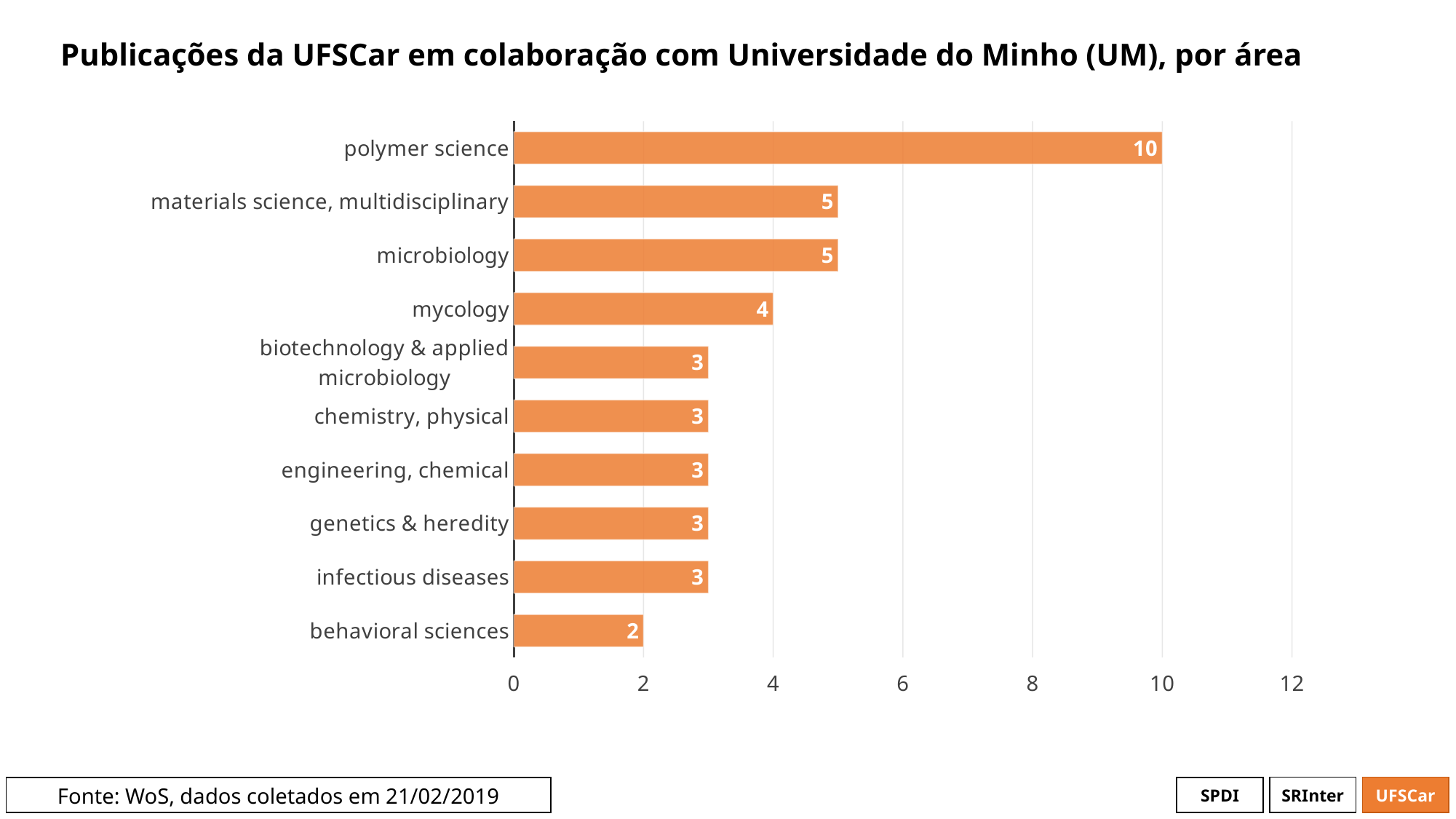
What is the value for microbiology? 5 What is the value for polymer science? 10 What is the value for behavioral sciences? 2 What kind of chart is shown on the slide? bar chart What is the title of the chart? Publicações da UFSCar em colaboração com Universidade do Minho (UM), por área Which is larger, the value for mycology or the value for infectious diseases? mycology What is the value for mycology? 4 Which area has the lowest value? behavioral sciences Is the value for polymer science greater or less than 8? greater Which area has the highest value? polymer science What is the difference between the values for polymer science and materials science, multidisciplinary? 5 How many areas are shown in the chart? 10